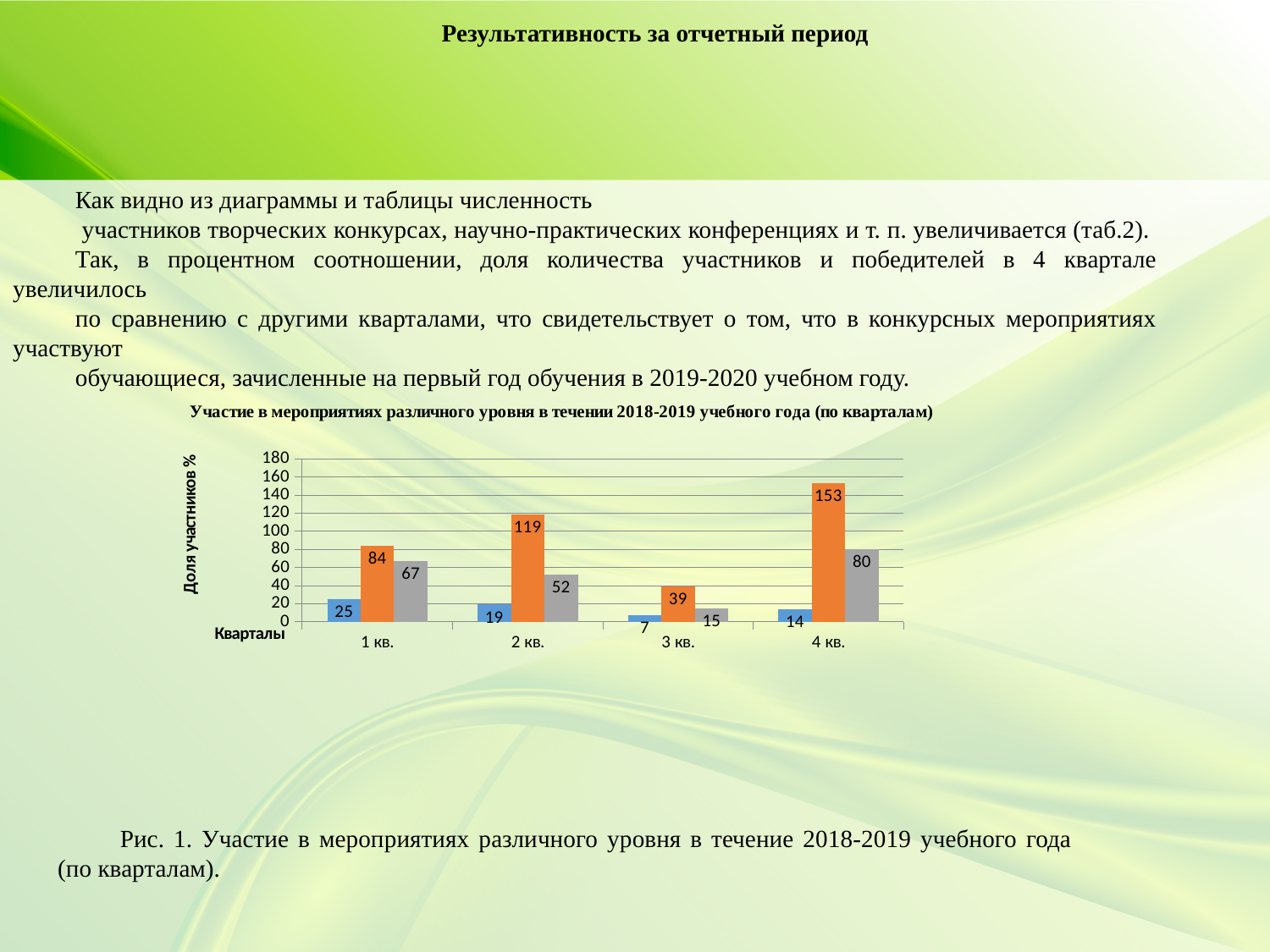
What is the value of the blue bar for 3 кв.? 7 Which is larger: the grey bar for 1 кв. or the grey bar for 4 кв.? 4 кв. Is the orange bar for 2 кв. greater or less than 100? greater What kind of chart is shown on the slide? bar chart What is the label of the vertical axis of the chart? Доля участников % In which quarter is the orange bar highest? 4 кв. In which quarter is the grey bar lowest? 3 кв. How many quarters are shown on the x axis? 4 What is the difference between the orange bar for 4 кв. and the orange bar for 2 кв.? 34 What is the value of the grey bar for 2 кв.? 52 What is the value of the blue bar for 1 кв.? 25 What is the value of the orange bar for 4 кв.? 153